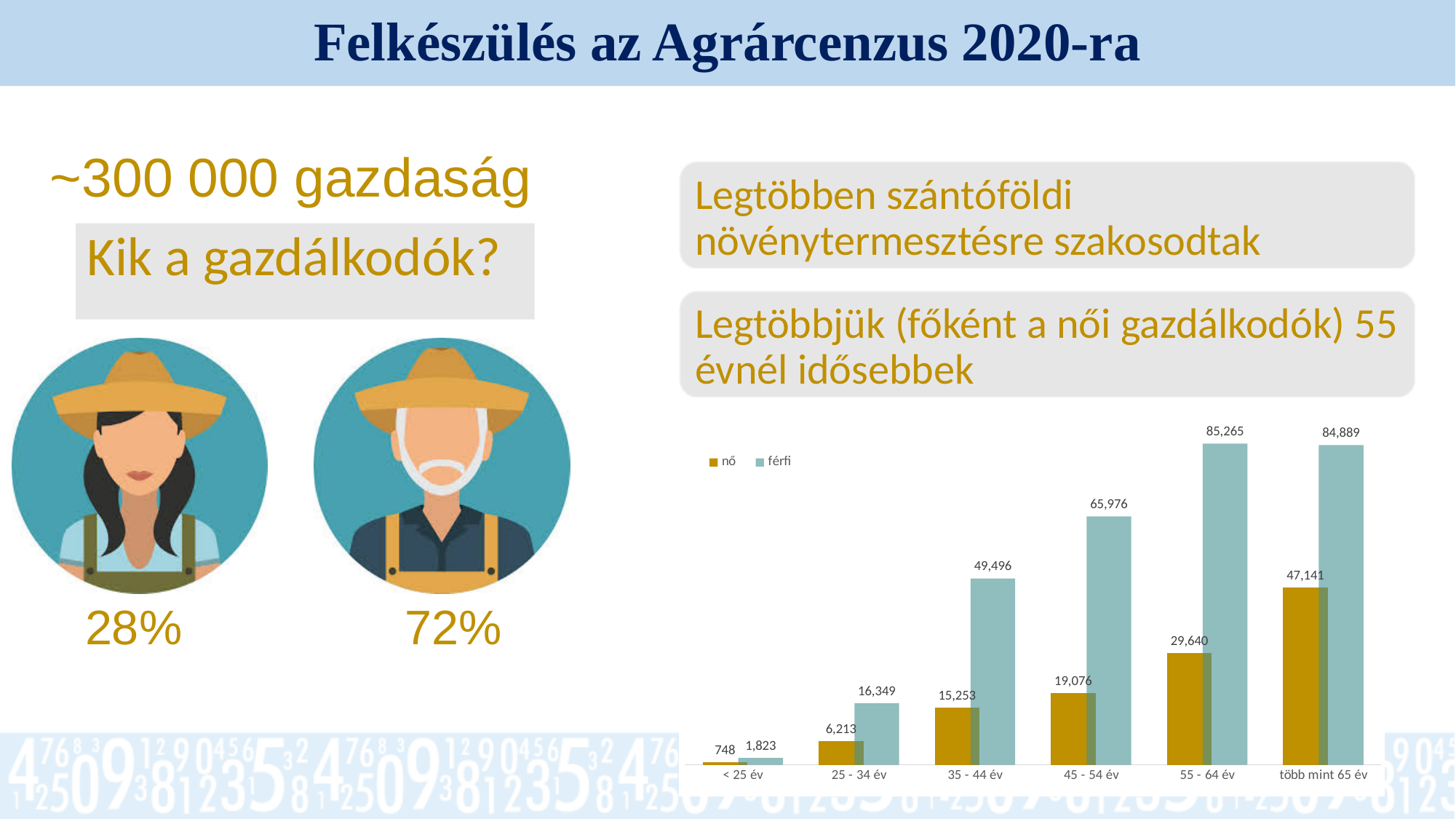
What are the two legend entries of the chart? nő and férfi Which age category has the lowest value for nő? < 25 év How many series does the chart legend list? 2 What type of chart is shown on the slide? bar chart What is the difference between the férfi and nő values in the 45 - 54 év category? 46,900 What is the value for férfi in the 35 - 44 év category? 49,496 Which age category has the highest value for férfi? 55 - 64 év Does the nő value rise or fall as the age categories move from < 25 év to több mint 65 év? rise Which is larger in the több mint 65 év category, the nő value or the férfi value? férfi What is the value for nő in the 55 - 64 év category? 29,640 What is the value for nő in the < 25 év category? 748 How many age categories are shown on the x axis of the chart? 6